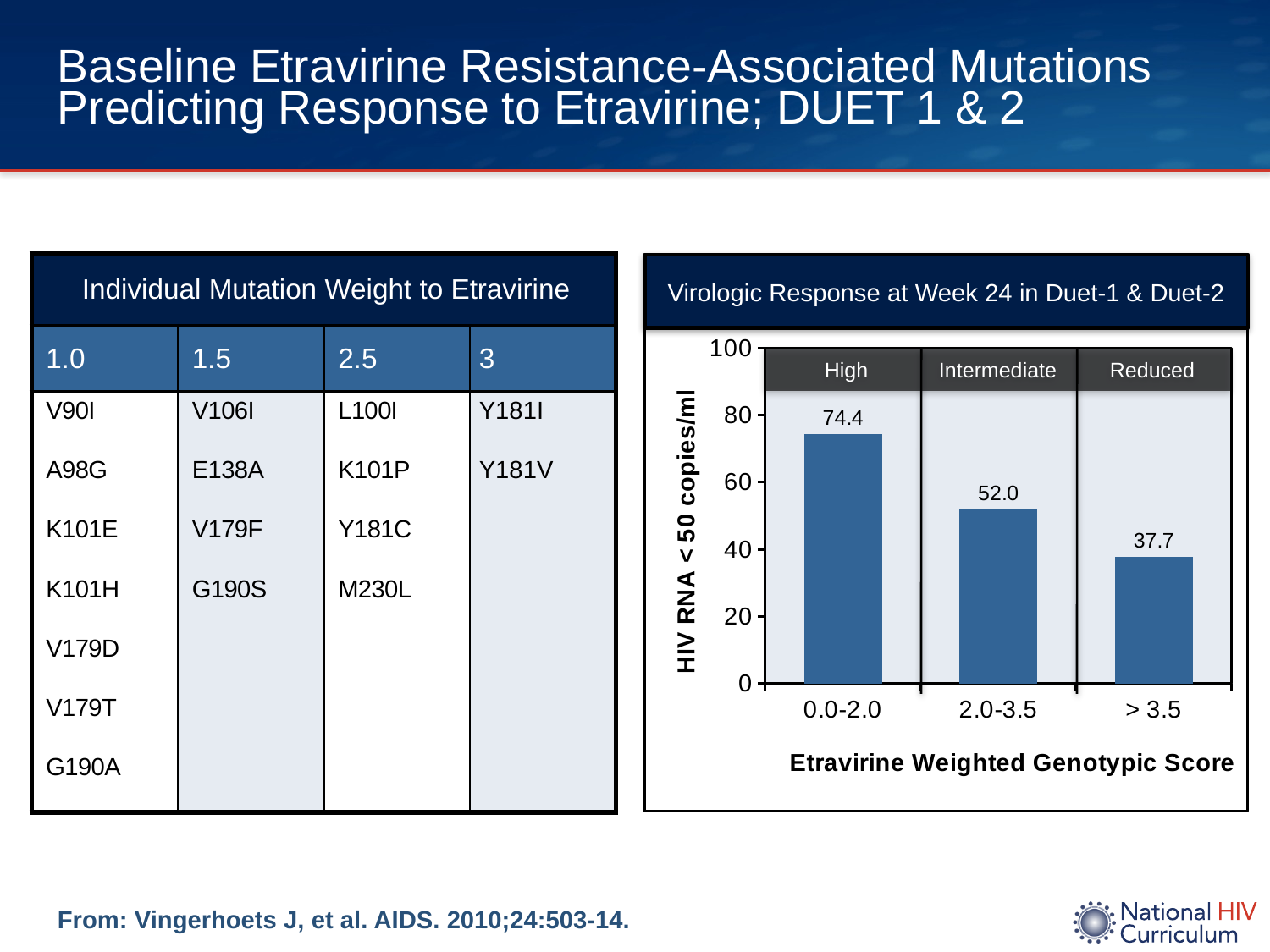
What is the label on the y axis of the bar chart? HIV RNA < 50 copies/ml Which has a higher virologic response, the 2.0-3.5 group or the > 3.5 group? 2.0-3.5 What is the difference in virologic response between the 0.0-2.0 group and the > 3.5 group? 36.7 Is the virologic response for the 2.0-3.5 group greater or less than 60? less Which genotypic score group has the lowest virologic response at week 24? > 3.5 What is the virologic response value for the 2.0-3.5 etravirine weighted genotypic score group? 52.0 What kind of chart is used to show virologic response at week 24? bar chart How many genotypic score groups are shown in the bar chart? 3 What is the virologic response value for the > 3.5 etravirine weighted genotypic score group? 37.7 What is the difference in virologic response between the 0.0-2.0 group and the 2.0-3.5 group? 22.4 Which genotypic score group has the highest virologic response at week 24? 0.0-2.0 What is the virologic response value for the 0.0-2.0 etravirine weighted genotypic score group? 74.4